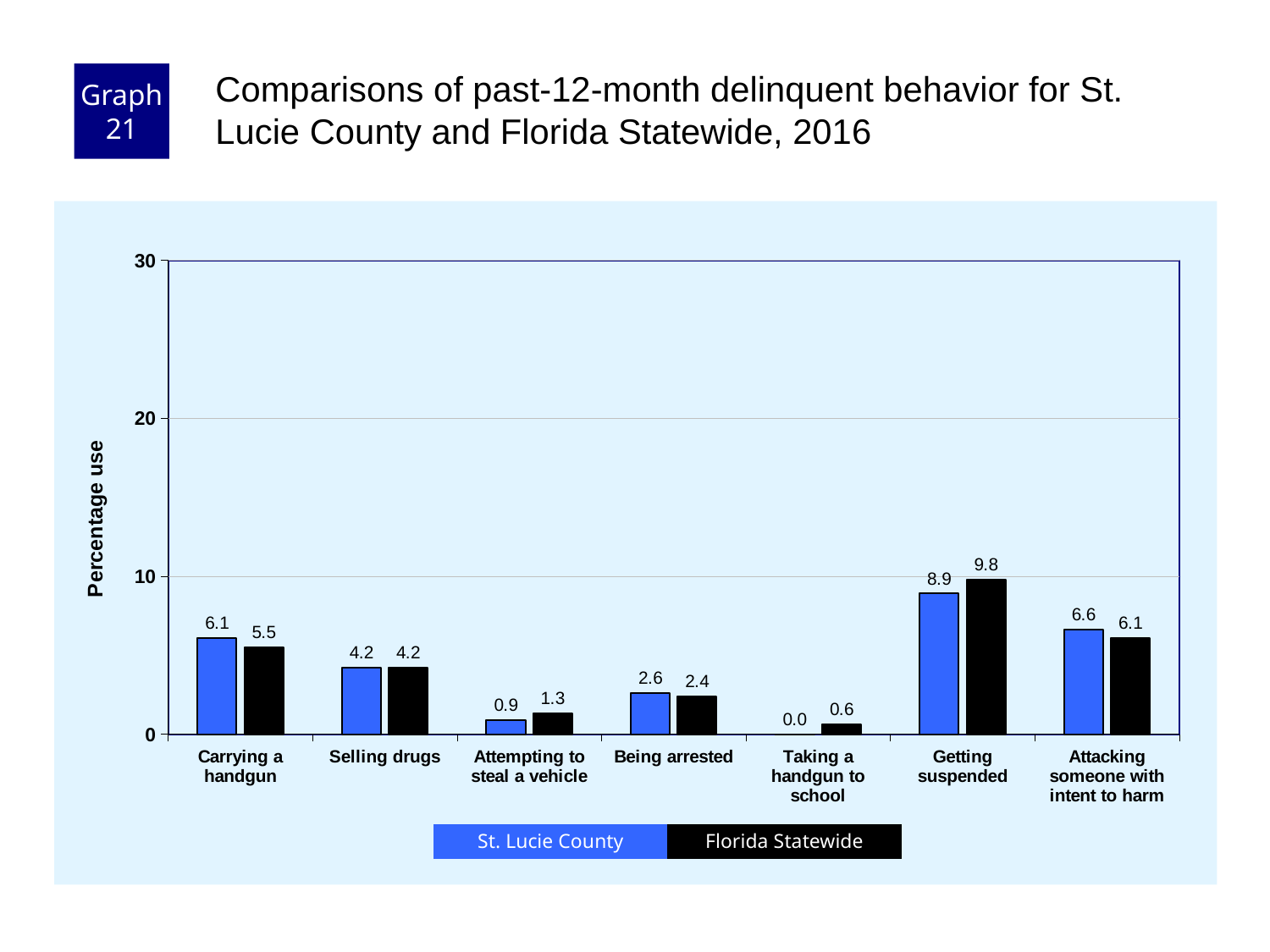
What is the Florida Statewide value for Attempting to steal a vehicle? 1.3 What is the label of the y axis? Percentage use Is the Florida Statewide value for Getting suspended greater or less than 10? less Which category has the lowest St. Lucie County value? Taking a handgun to school How many categories are shown on the x axis? 7 How many series does the legend list? 2 What is the St. Lucie County value for Getting suspended? 8.9 What is the St. Lucie County value for Taking a handgun to school? 0.0 Which is larger for Carrying a handgun: St. Lucie County or Florida Statewide? St. Lucie County What is the difference between the Florida Statewide and St. Lucie County values for Getting suspended? 0.9 Which category has the highest Florida Statewide value? Getting suspended What kind of chart is shown on the slide? bar chart